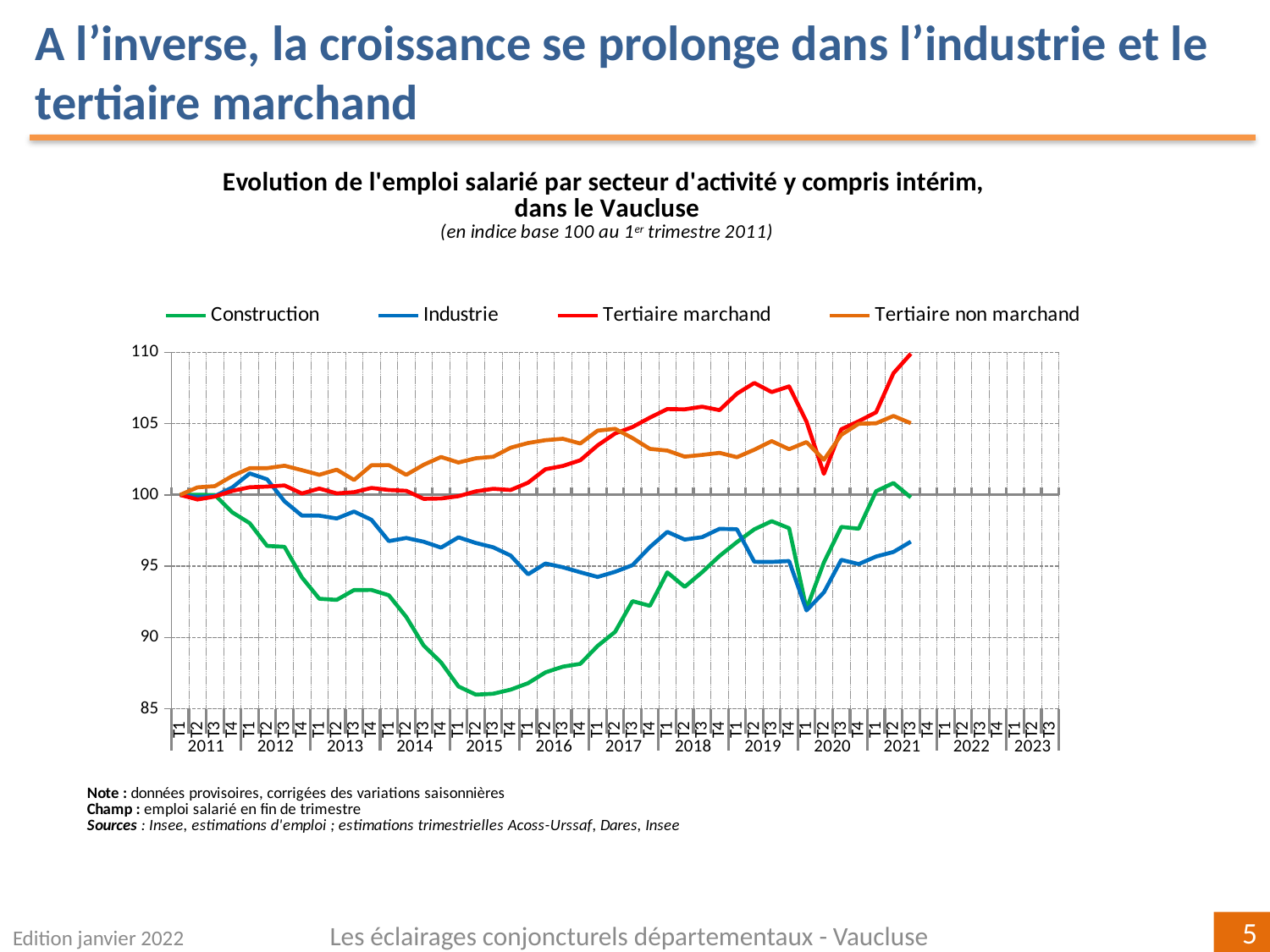
What is the base period of the index used in the chart, according to the subtitle? 1er trimestre 2011 What kind of chart is shown on the slide? line chart Which series has the highest value at T3 2021? Tertiaire marchand How many series does the legend list? 4 Which series is shown in red in the legend? Tertiaire marchand Is the value for Tertiaire non marchand at T1 2016 greater or less than 100? greater Is the value for Tertiaire marchand at T2 2019 greater or less than 105? greater Is the value for Construction at T2 2015 greater or less than 90? less Which series has the lowest value at T2 2015? Construction Does the Construction series rise or fall between T1 2011 and T2 2015? fall What is the index value of all four series at T1 2011? 100